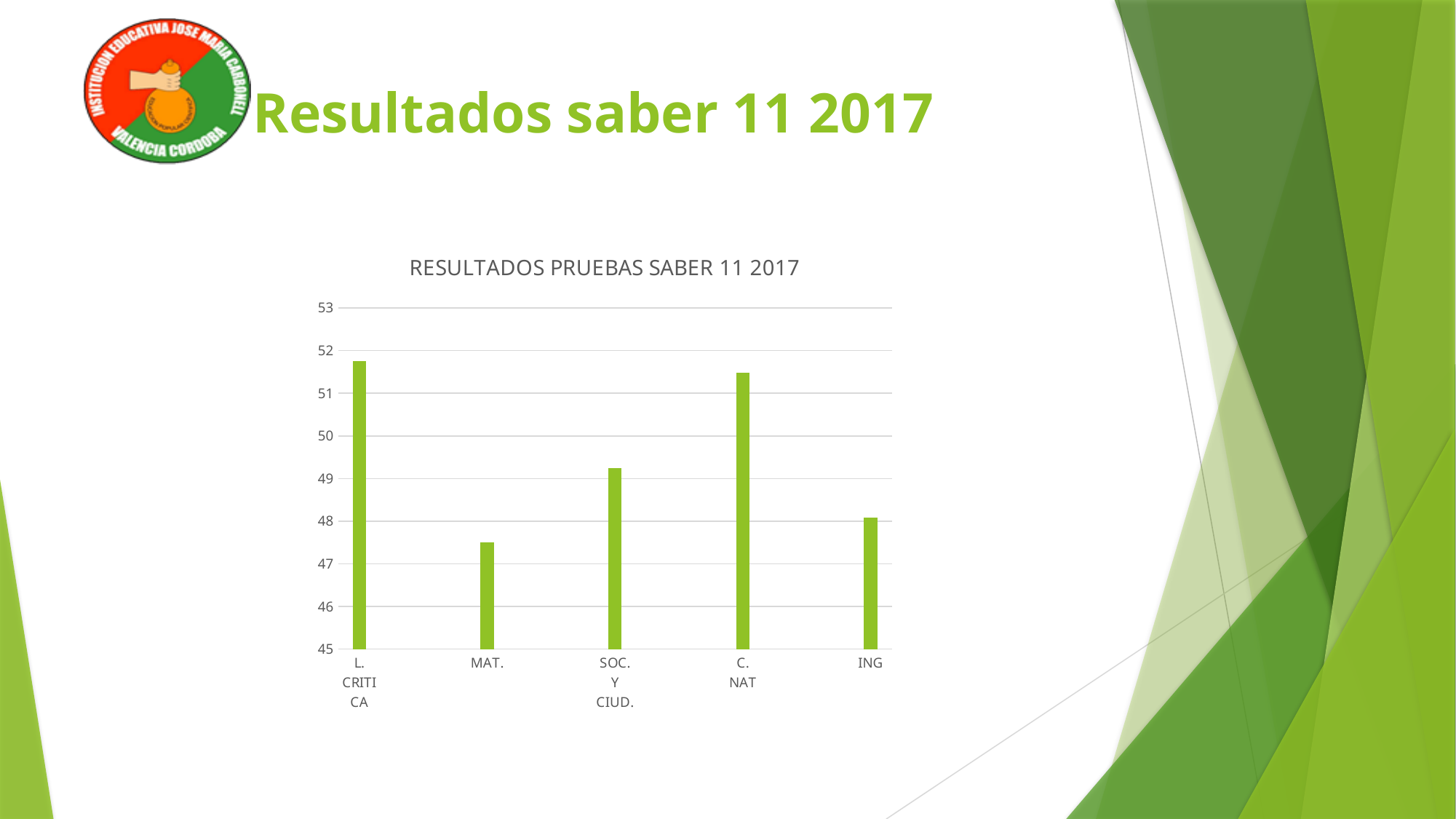
Is the value for ING greater or less than 49? less Is the value for L. CRITICA greater or less than 51? greater What is the title of the chart? RESULTADOS PRUEBAS SABER 11 2017 Which has a larger value, MAT. or ING? ING What kind of chart is shown on the slide? bar chart How many categories are plotted in the chart? 5 Is the value for MAT. greater or less than 48? less What colour are the bars in the chart? green Which category has the lowest value in the chart? MAT. Which has a larger value, SOC. Y CIUD. or C. NAT? C. NAT